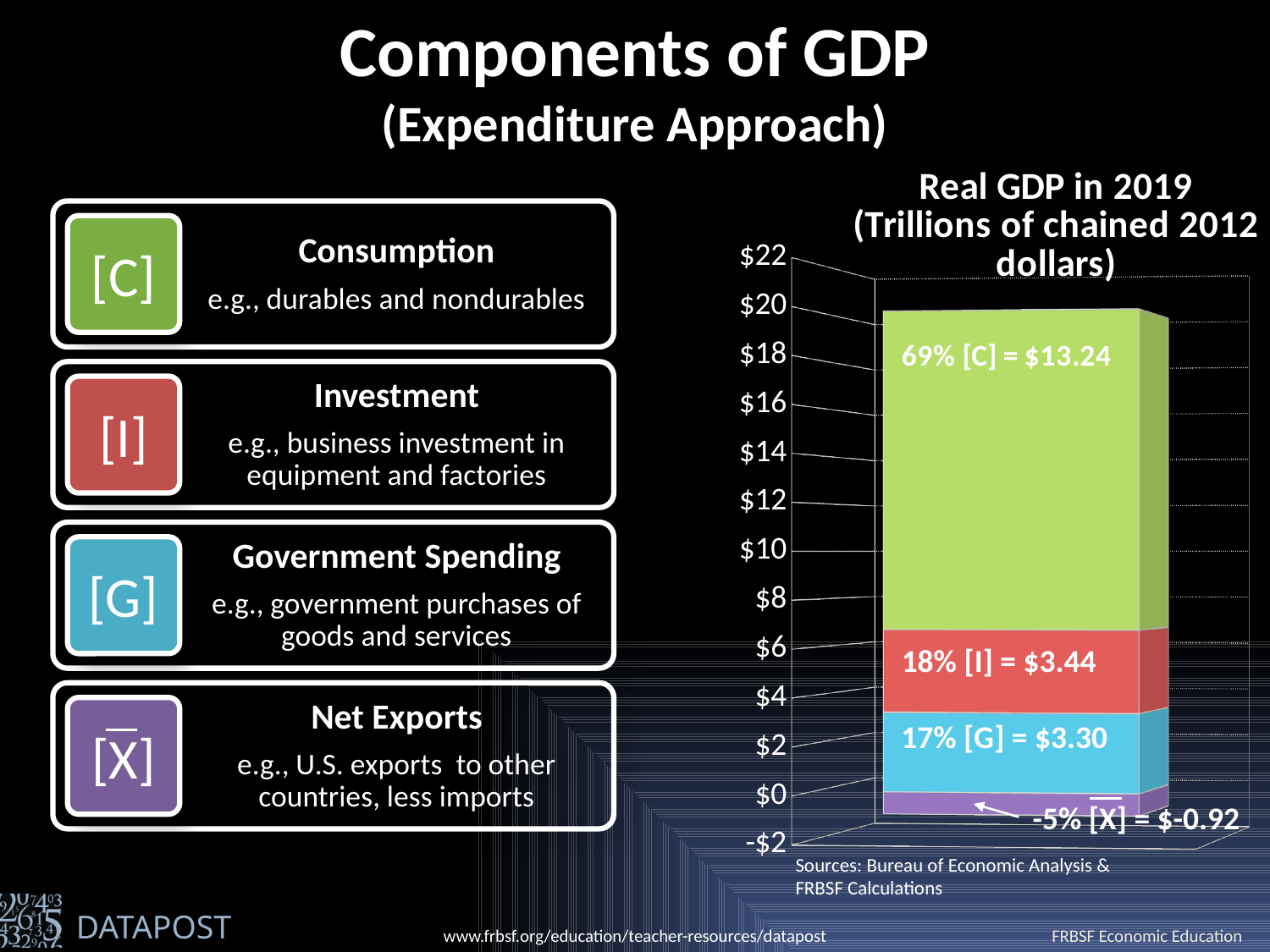
What is the title of the chart? Real GDP in 2019 (Trillions of chained 2012 dollars) What percentage share of real GDP does Consumption [C] account for? 69% What is the value of Government Spending [G] in the Real GDP in 2019 chart? $3.30 How many GDP components are shown as segments in the stacked bar? 4 Which is larger, the value for Investment [I] or the value for Government Spending [G]? Investment [I] Which component of GDP has the largest value in the chart? Consumption [C] Which component of GDP has the smallest value in the chart? Net Exports [X] What is the difference between the Consumption [C] value and the Investment [I] value? $9.80 What is the value of Investment [I] in the Real GDP in 2019 chart? $3.44 What kind of chart is shown on the slide? Stacked bar chart What is the value of Consumption [C] in the Real GDP in 2019 chart? $13.24 What is the value of Net Exports [X] in the Real GDP in 2019 chart? $-0.92